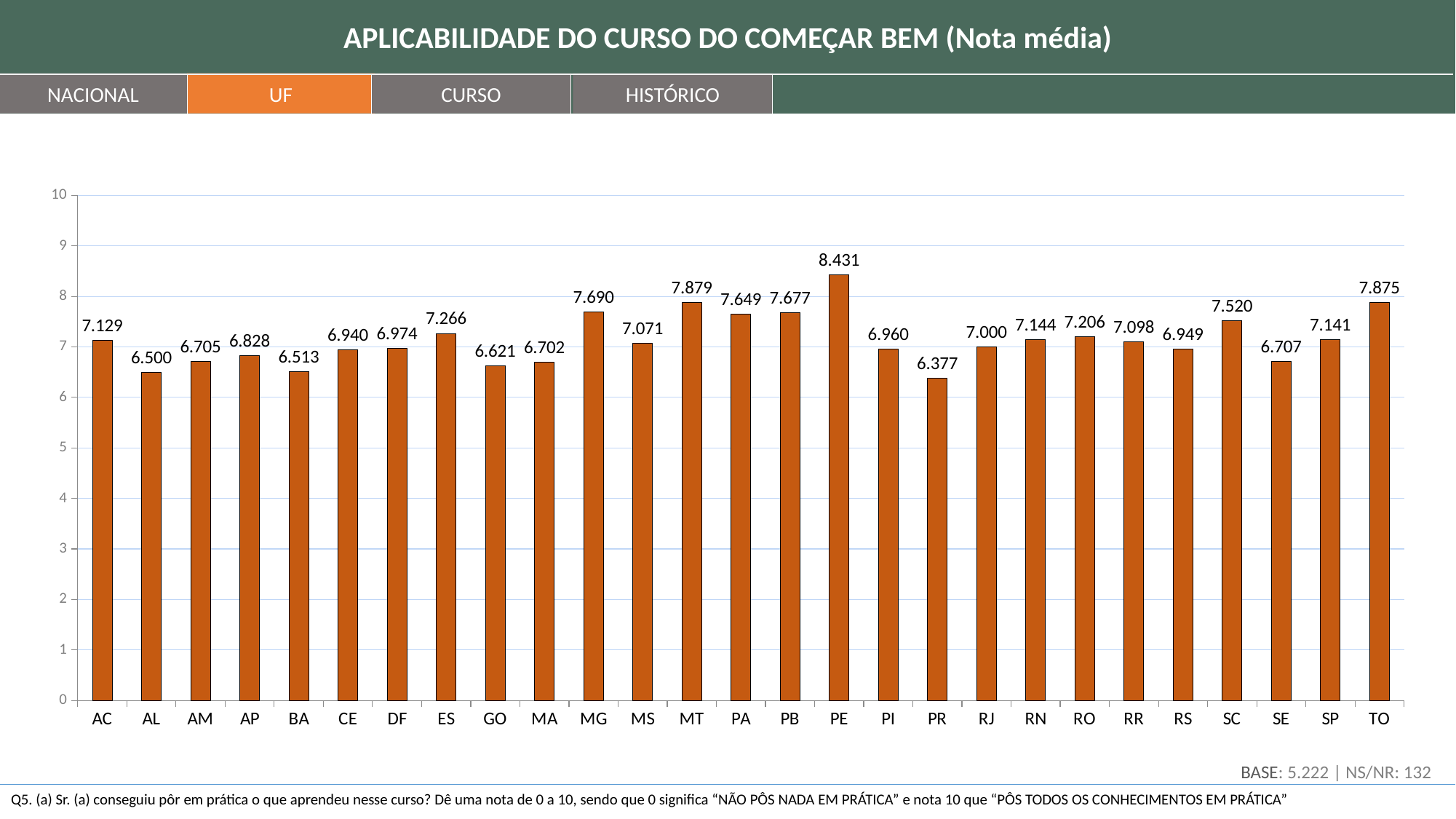
What is the title of the chart? APLICABILIDADE DO CURSO DO COMEÇAR BEM (Nota média) Is the value for AL greater or less than 7? less How many UFs are shown on the x axis? 27 What is the difference between the values for SC and AC? 0.391 Which is larger, the value for MG or the value for MS? MG What is the value for SC? 7.520 Which UF has the highest value? PE What is the value for RJ? 7.000 What kind of chart is shown? bar chart Which UF has the lowest value? PR What is the difference between the values for PE and PR? 2.054 What is the value for PE? 8.431